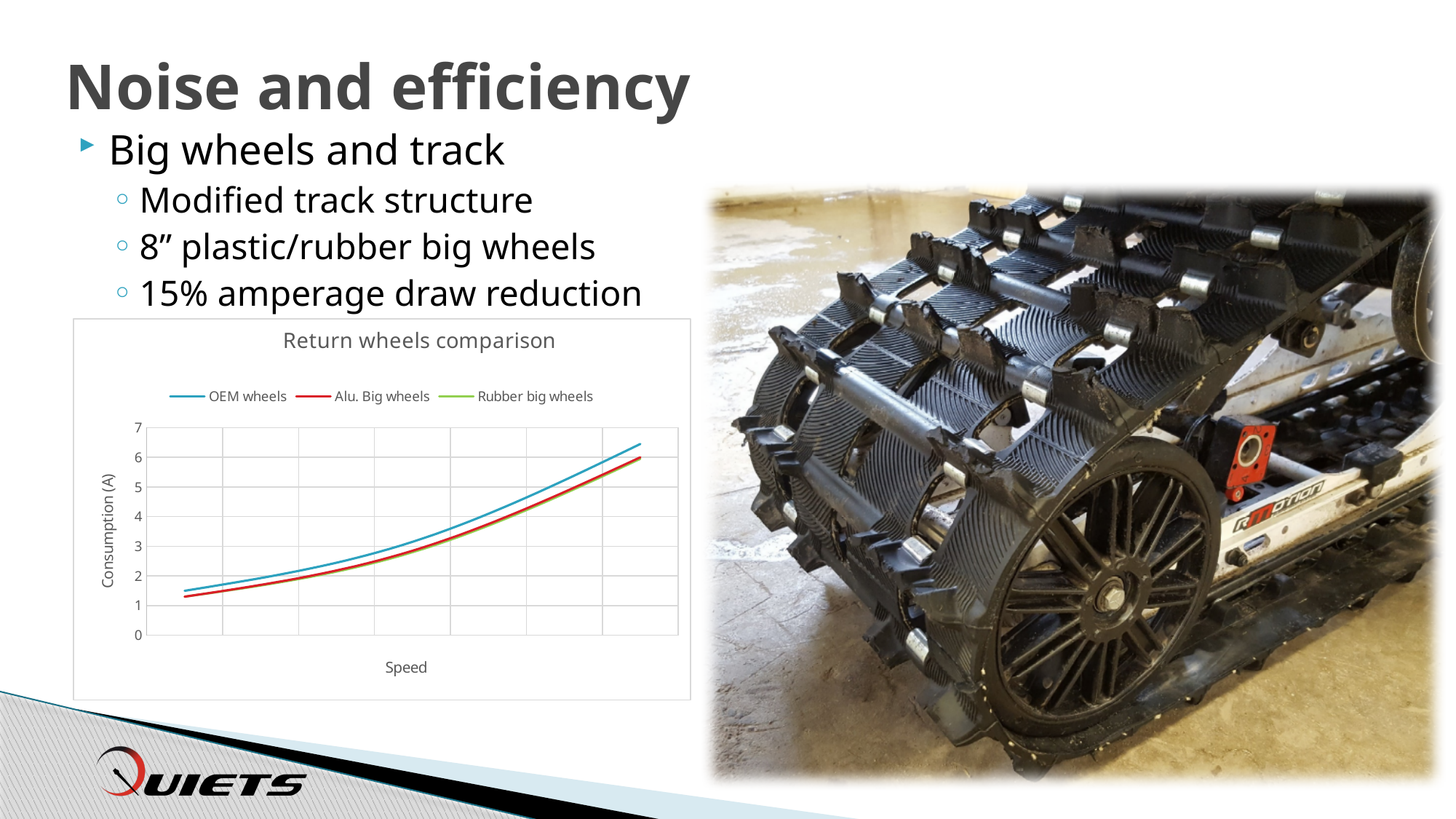
Is the highest value for OEM wheels greater or less than 6? greater What kind of chart is shown on the slide? line chart Is the lowest value for Alu. Big wheels greater or less than 2? less Is the highest value for OEM wheels greater or less than 7? less Do the values for Rubber big wheels rise or fall along the x axis? rise Do the values for OEM wheels rise or fall as speed increases along the x axis? rise Which is larger at the right end of the chart, the value for OEM wheels or the value for Alu. Big wheels? OEM wheels What is the label of the vertical axis of the chart? Consumption (A) Which series has the highest consumption at the right end of the chart? OEM wheels What is the title of the chart? Return wheels comparison How many series does the chart legend list? 3